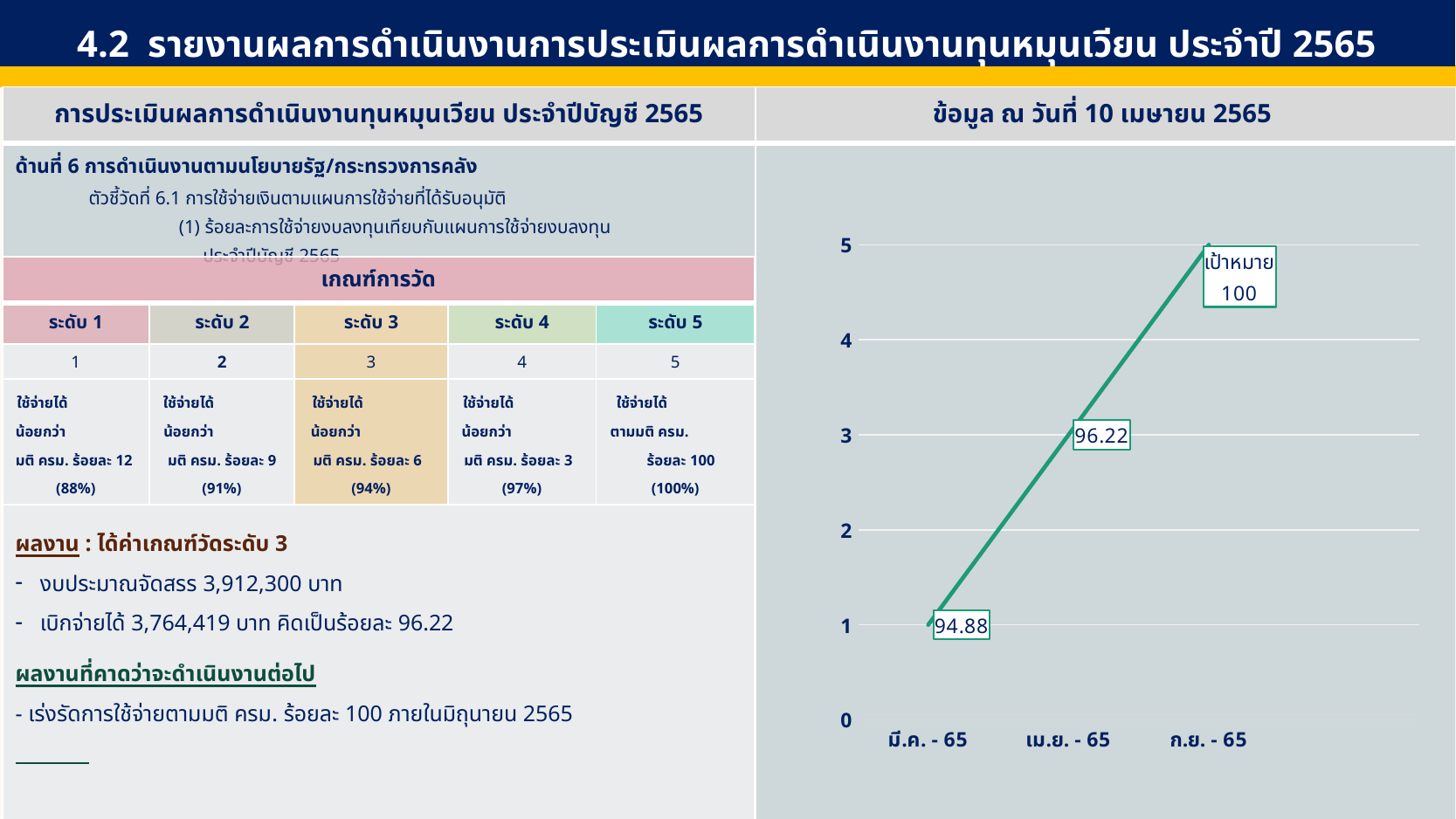
What word appears in the label box next to the ก.ย. - 65 point on the line chart? เป้าหมาย Is the plotted point for เม.ย. - 65 on the line chart greater or less than 2 on the y axis? greater Do the values on the line chart rise or fall from มี.ค. - 65 to ก.ย. - 65? rise Which category on the line chart has the lowest plotted point? มี.ค. - 65 What is the data label shown for เม.ย. - 65 on the line chart? 96.22 What is the data label shown for มี.ค. - 65 on the line chart? 94.88 Is the plotted point for มี.ค. - 65 on the line chart greater or less than 2 on the y axis? less Which category on the line chart has the highest plotted point? ก.ย. - 65 Which is larger on the line chart, the plotted point for เม.ย. - 65 or for มี.ค. - 65? เม.ย. - 65 How many data points are plotted on the line chart? 3 What kind of chart is shown on the right side of the slide? line chart What is the data label shown for ก.ย. - 65 on the line chart? เป้าหมาย 100